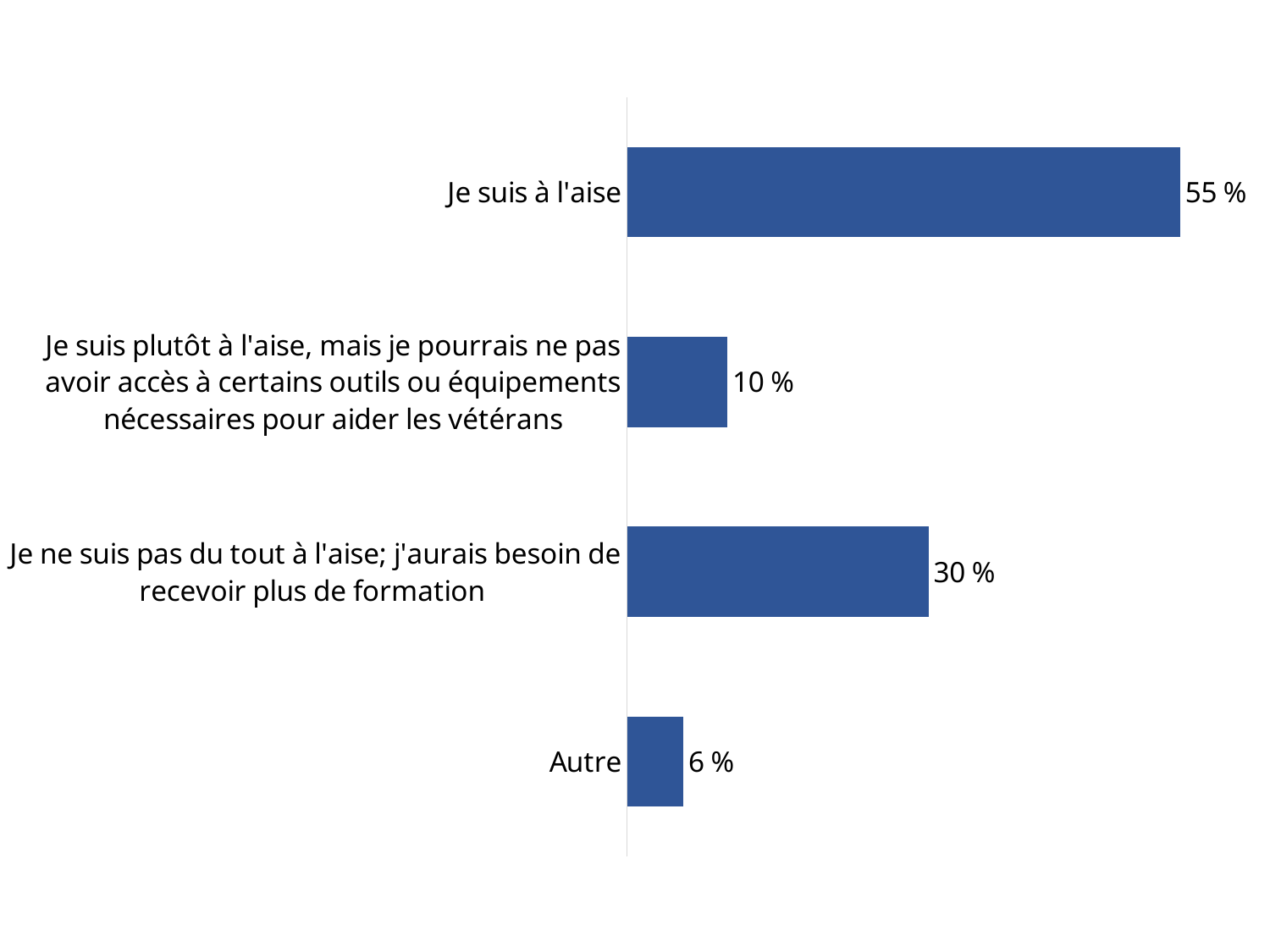
What is the value for "Je ne suis pas du tout à l'aise; j'aurais besoin de recevoir plus de formation"? 30 % Which category has the highest value? Je suis à l'aise Which category has the lowest value? Autre What kind of chart is shown on the slide? Bar chart What is the value for "Je suis plutôt à l'aise, mais je pourrais ne pas avoir accès à certains outils ou équipements nécessaires pour aider les vétérans"? 10 % What is the value for "Autre"? 6 % How many categories are shown in the chart? 4 What is the difference between the values for "Je suis à l'aise" and "Je ne suis pas du tout à l'aise; j'aurais besoin de recevoir plus de formation"? 25 % What colour are the bars in the chart? Blue What is the difference between the values for "Je suis plutôt à l'aise, mais je pourrais ne pas avoir accès à certains outils ou équipements nécessaires pour aider les vétérans" and "Autre"? 4 % Which is larger: the value for "Je ne suis pas du tout à l'aise; j'aurais besoin de recevoir plus de formation" or the value for "Je suis plutôt à l'aise, mais je pourrais ne pas avoir accès à certains outils ou équipements nécessaires pour aider les vétérans"? Je ne suis pas du tout à l'aise; j'aurais besoin de recevoir plus de formation What is the value for "Je suis à l'aise"? 55 %